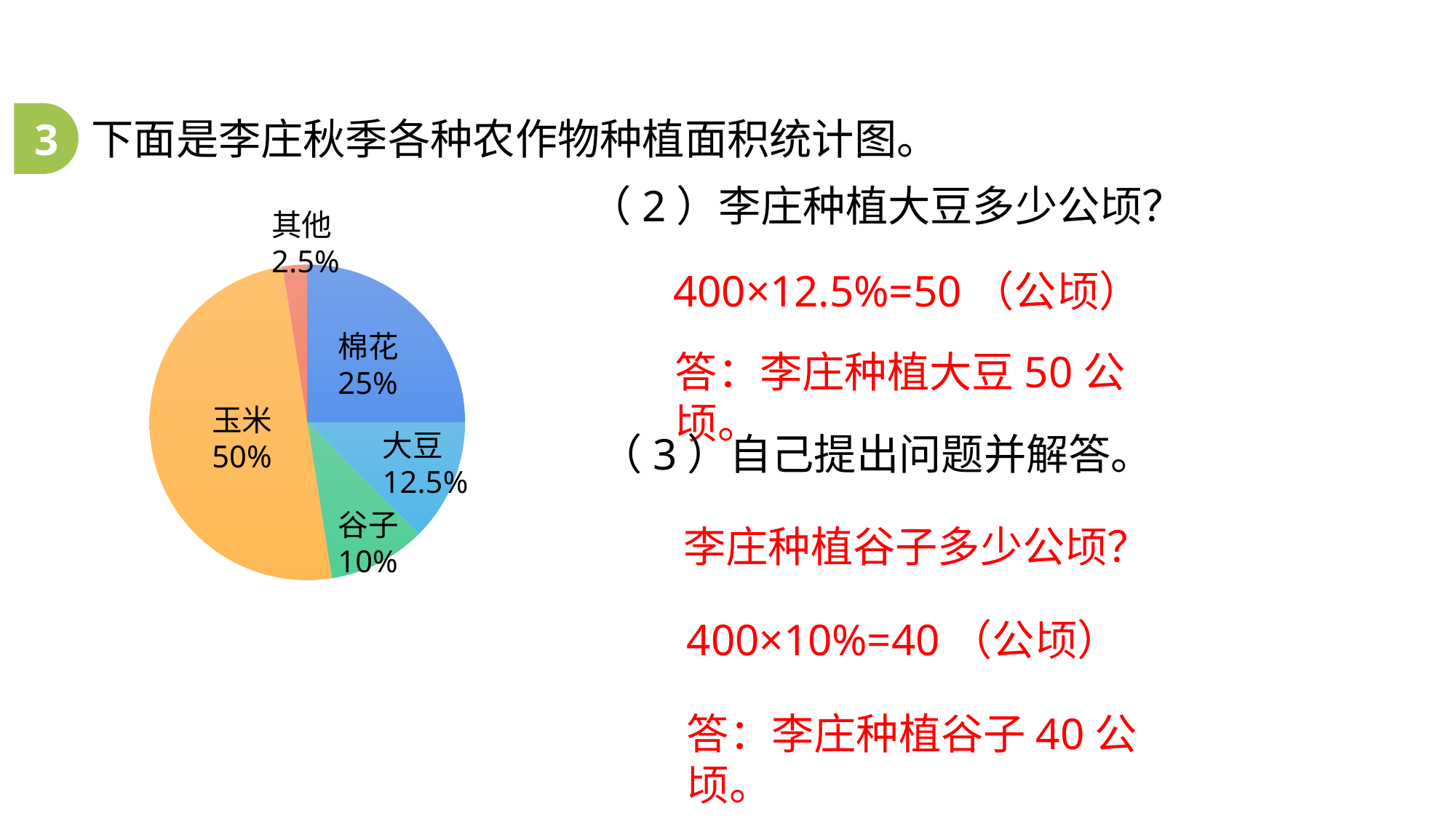
Which slice is larger, 谷子 or 大豆? 大豆 Which crop has the largest slice of the pie? 玉米 What share of the pie does 棉花 take? 25% What share of the pie does 大豆 take? 12.5% What is the difference in percentage points between 棉花 and 大豆? 12.5% What share of the pie does 玉米 take? 50% What kind of chart is shown on the slide? pie chart What colour is the 玉米 slice? orange Which category has the smallest slice of the pie? 其他 How many slices does the pie chart have? 5